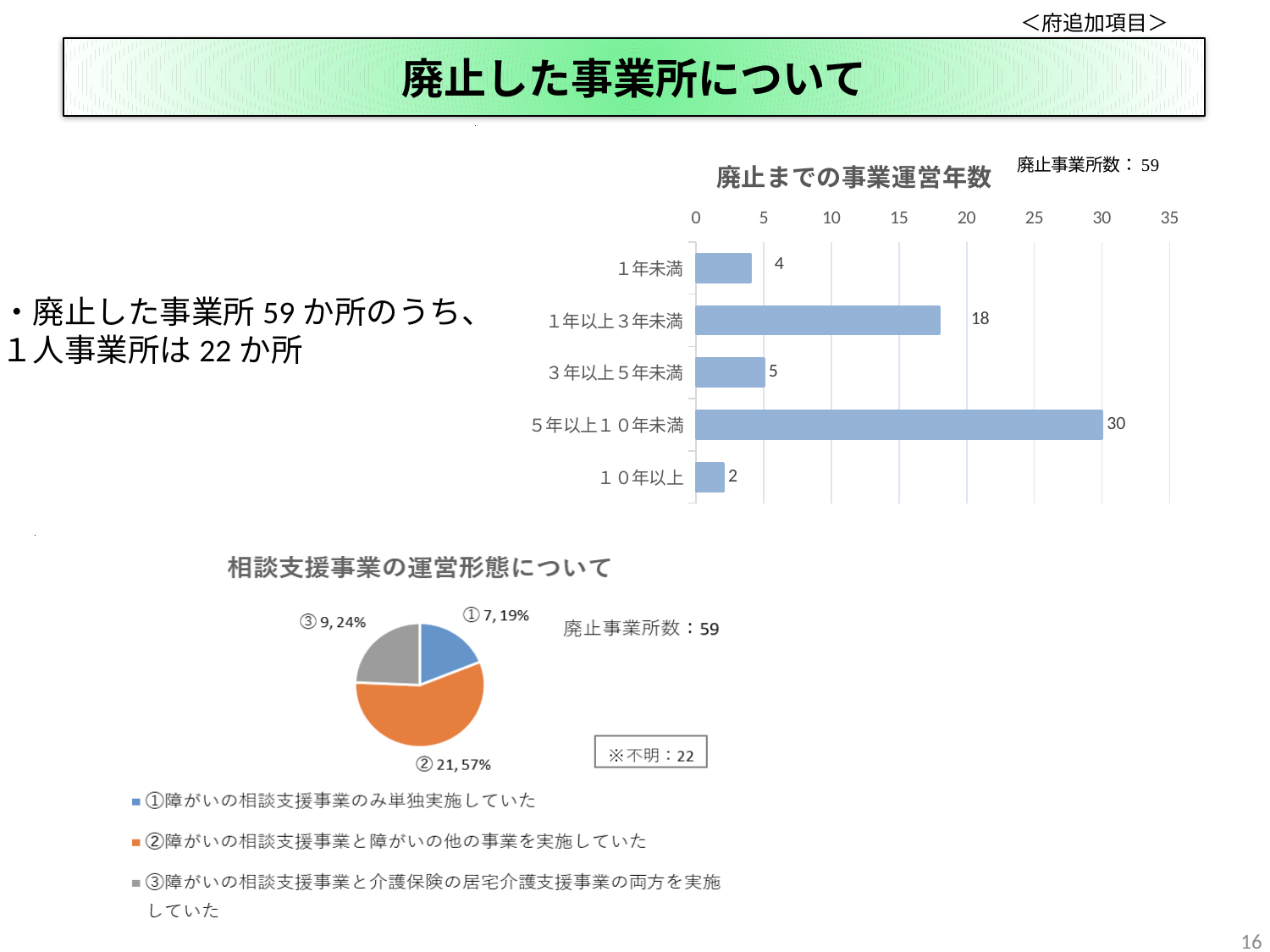
In the bar chart titled 廃止までの事業運営年数, which is larger: the value for 1年未満 or the value for 3年以上5年未満? 3年以上5年未満 In the bar chart titled 廃止までの事業運営年数, which category has the highest value? 5年以上１０年未満 In the bar chart titled 廃止までの事業運営年数, what is the value for 1年以上3年未満? 18 In the bar chart titled 廃止までの事業運営年数, what is the value for 5年以上１０年未満? 30 In the pie chart titled 相談支援事業の運営形態について, what is the value for slice ③? 9 What kind of chart is the chart titled 廃止までの事業運営年数? bar chart How many entries does the legend of the pie chart titled 相談支援事業の運営形態について list? 3 How many categories are shown in the bar chart titled 廃止までの事業運営年数? 5 In the pie chart titled 相談支援事業の運営形態について, what share does slice ② have? 57% In the bar chart titled 廃止までの事業運営年数, which category has the lowest value? １０年以上 In the pie chart titled 相談支援事業の運営形態について, which slice is the largest? ② In the bar chart titled 廃止までの事業運営年数, what is the difference between the values for 5年以上１０年未満 and 1年以上3年未満? 12